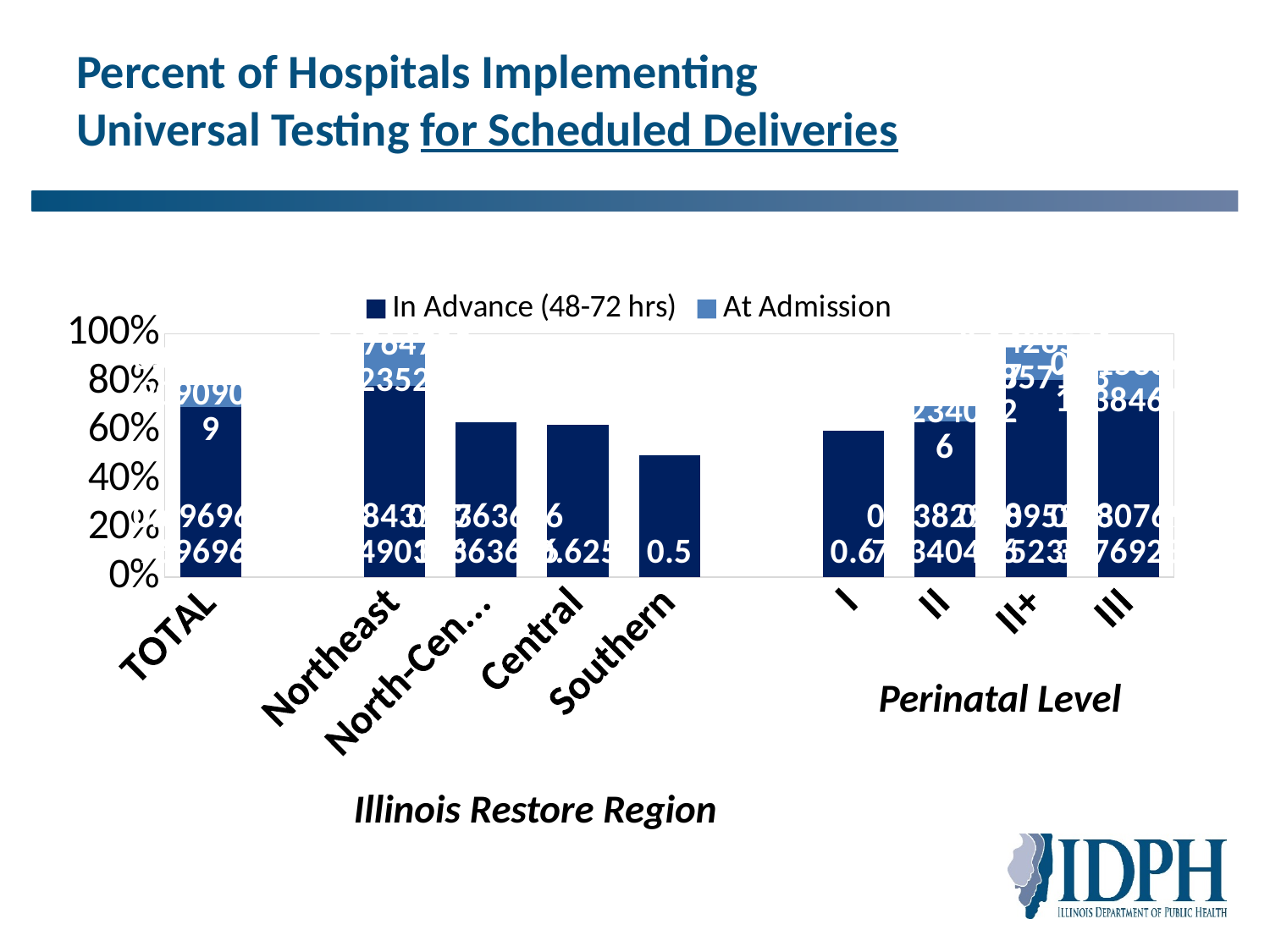
Is the In Advance (48-72 hrs) value for Northeast greater or less than 60%? greater What kind of chart is shown on the slide? bar chart How many series does the legend list? 2 What are the two series named in the legend? In Advance (48-72 hrs) and At Admission What is the title of the chart? Percent of Hospitals Implementing Universal Testing for Scheduled Deliveries Which has the larger In Advance (48-72 hrs) value, TOTAL or Southern? TOTAL How many categories are shown along the x axis? 9 Among the Illinois Restore Regions (Northeast, North-Central, Central, Southern), which has the lowest In Advance (48-72 hrs) value? Southern Is the In Advance (48-72 hrs) value for II+ greater or less than 60%? greater Is the In Advance (48-72 hrs) value for Southern greater or less than 60%? less Among the Perinatal Levels (I, II, II+, III), which has the lowest In Advance (48-72 hrs) value? I Among the Illinois Restore Regions (Northeast, North-Central, Central, Southern), which has the highest In Advance (48-72 hrs) value? Northeast